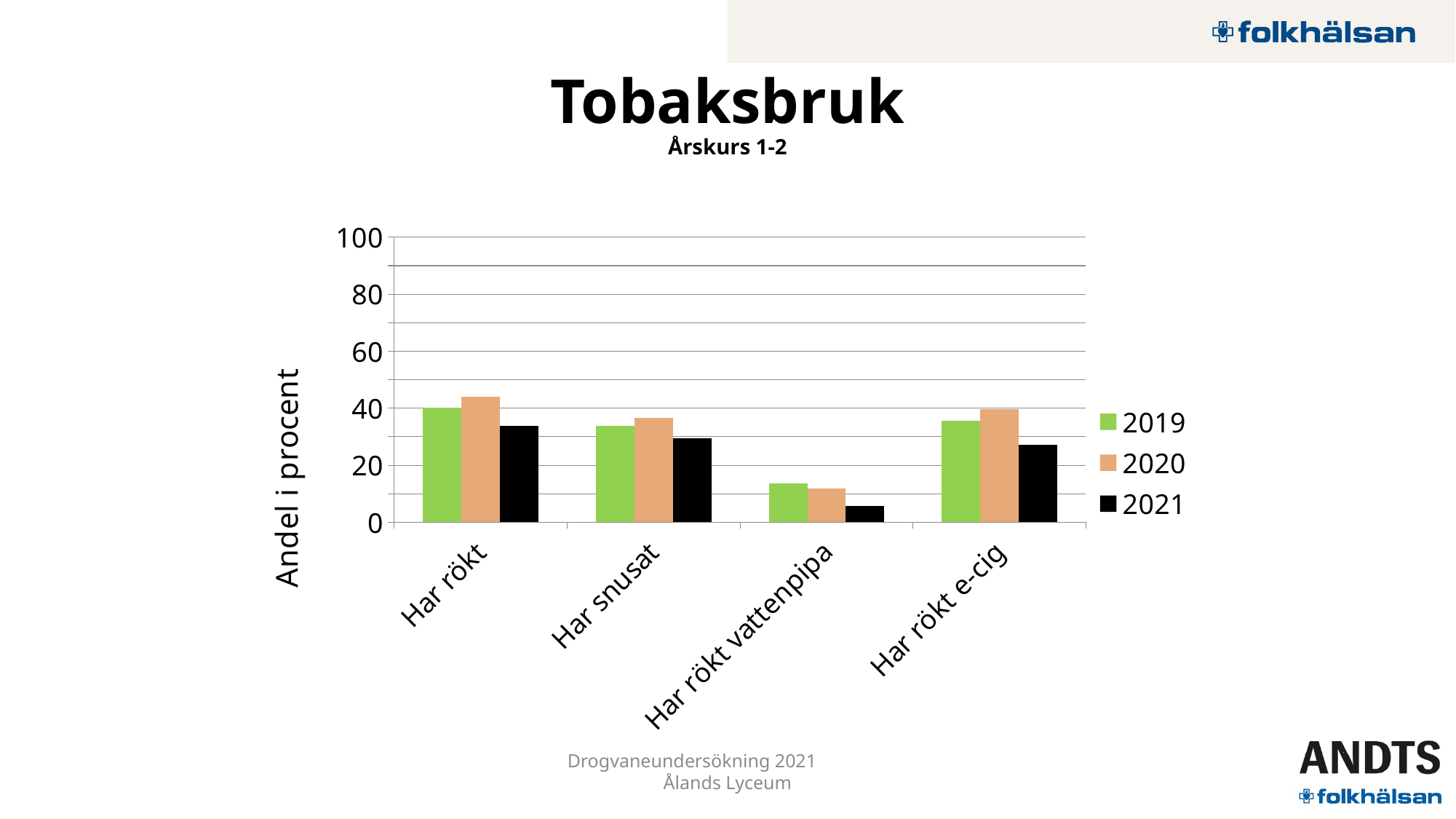
How many series does the chart's legend list? 3 Is the value for Har rökt e-cig in 2021 greater or less than 20? greater For Har rökt e-cig, do the values rise or fall from 2020 to 2021? fall Which category has the highest bar for 2020? Har rökt Which category has the lowest bar for 2021? Har rökt vattenpipa What is the label on the chart's y axis? Andel i procent Is the value for Har rökt in 2020 greater or less than 40? greater How many categories are shown on the x axis of the chart? 4 For Har rökt, which is larger: the 2020 value or the 2021 value? 2020 Is the value for Har rökt vattenpipa in 2021 greater or less than 20? less What kind of chart is shown on the slide? bar chart